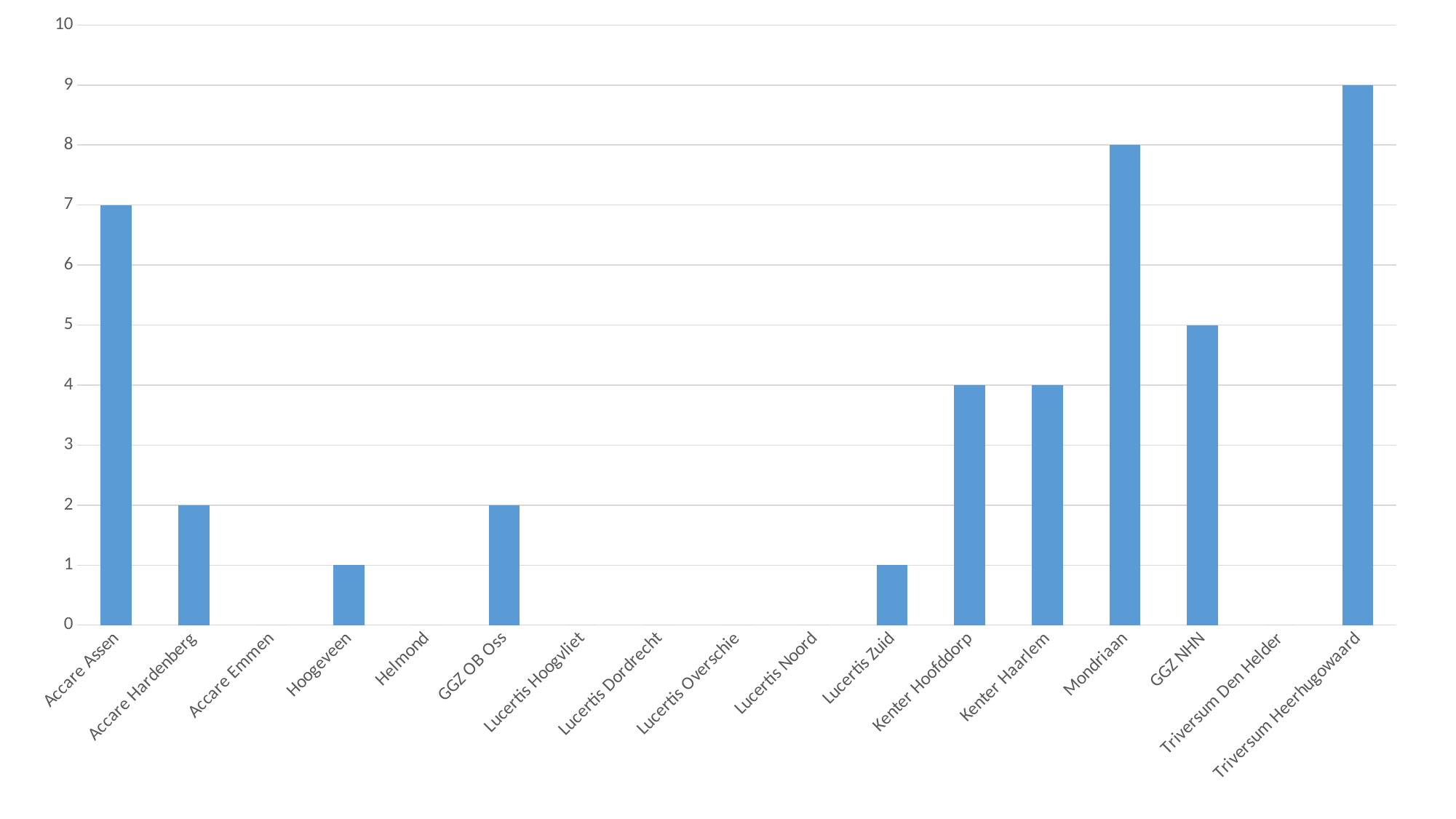
What is the value for GGZ NHN? 5 What is the value for Accare Assen? 7 What is the difference between the values for Accare Assen and GGZ NHN? 2 What is the value for Mondriaan? 8 What type of chart is shown on the slide? bar chart Which is larger, the value for Mondriaan or the value for Accare Assen? Mondriaan What is the difference between the values for Triversum Heerhugowaard and Mondriaan? 1 What is the value for Triversum Heerhugowaard? 9 Is the value for Mondriaan greater or less than 5? greater Which category has the highest bar in the chart? Triversum Heerhugowaard What is the value for Kenter Hoofddorp? 4 How many categories are shown on the x axis of the chart? 17